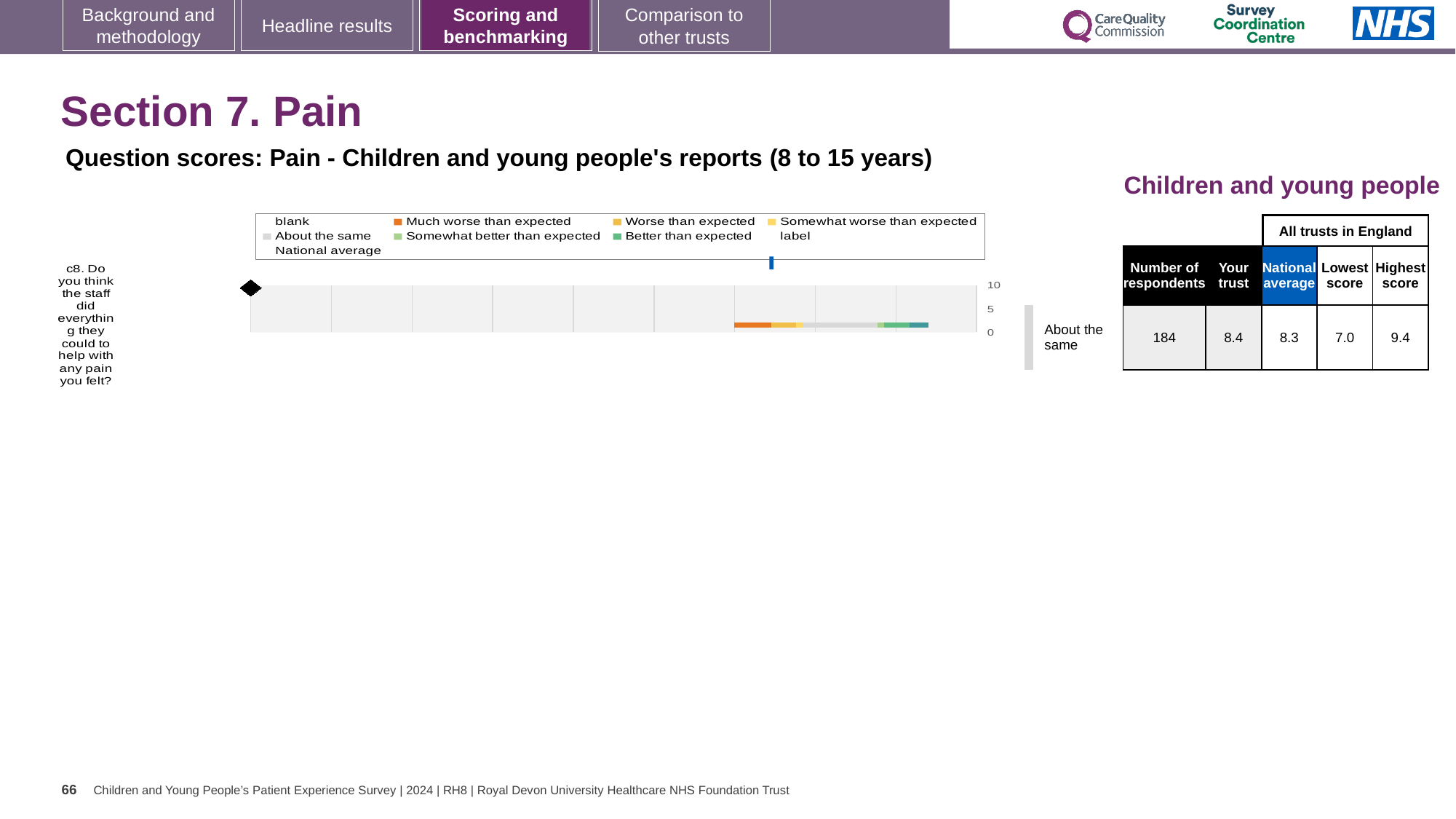
Which survey question is plotted on the chart? c8. Do you think the staff did everything they could to help with any pain you felt? What benchmark category is the trust's result for question c8 assigned to, as labelled next to the chart? About the same What kind of chart is shown on the slide? Bar chart According to the table beside the chart, what is the national average score for question c8? 8.3 According to the table beside the chart, what is the 'Your trust' score for question c8? 8.4 According to the table beside the chart, how many respondents answered question c8? 184 What is the difference between the highest score and the lowest score for question c8 in the table beside the chart? 2.4 According to the table beside the chart, what is the highest score among all trusts in England for question c8? 9.4 According to the table beside the chart, what is the lowest score among all trusts in England for question c8? 7.0 Is the 'Your trust' score for question c8 higher or lower than the national average? Higher What is the maximum value shown on the chart's axis? 10 How many survey questions (categories) are plotted on the chart? 1